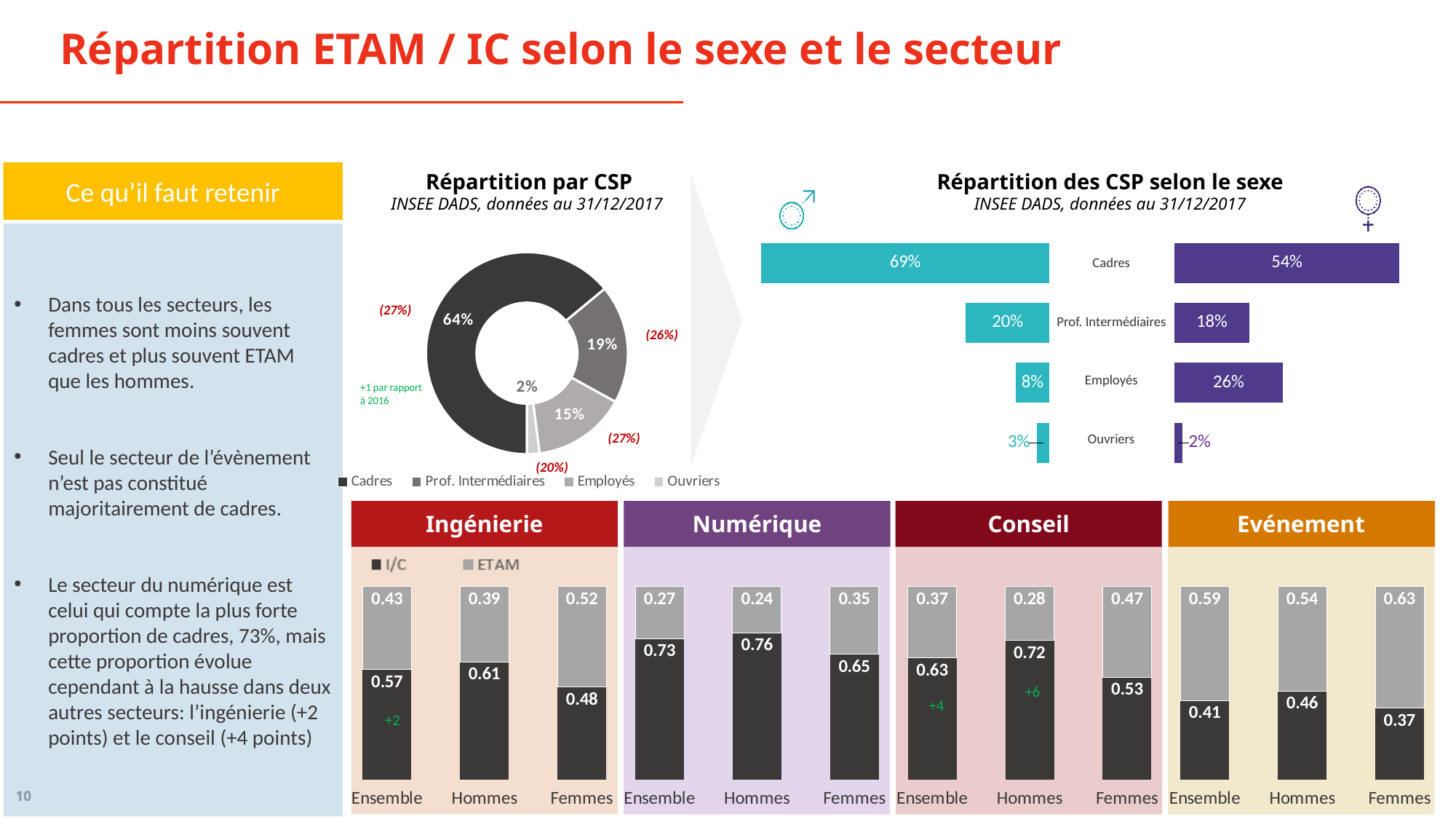
In the 'Répartition des CSP selon le sexe' chart, what is the difference between the men's and women's values for Cadres? 15 points In the 'Répartition par CSP' donut chart, what share is shown for Cadres? 64% What kind of chart is used for the 'Evénement' sector? Stacked bar chart In the 'Ingénierie' chart, what is the I/C value for Femmes? 0.48 How many categories does the legend of the 'Répartition par CSP' donut chart list? 4 In the 'Répartition des CSP selon le sexe' chart, what is the value for Cadres among men (left side)? 69% In the 'Répartition par CSP' donut chart, what share is shown for Employés? 15% In the 'Numérique' chart, what is the ETAM value for Hommes? 0.24 In the 'Répartition des CSP selon le sexe' chart, what is the value for Employés among women (right side)? 26% In the 'Répartition des CSP selon le sexe' chart, is the Employés value larger for men or for women? Women In the 'Répartition par CSP' donut chart, which category has the smallest share? Ouvriers In the 'Conseil' chart, which group has the highest I/C value? Hommes